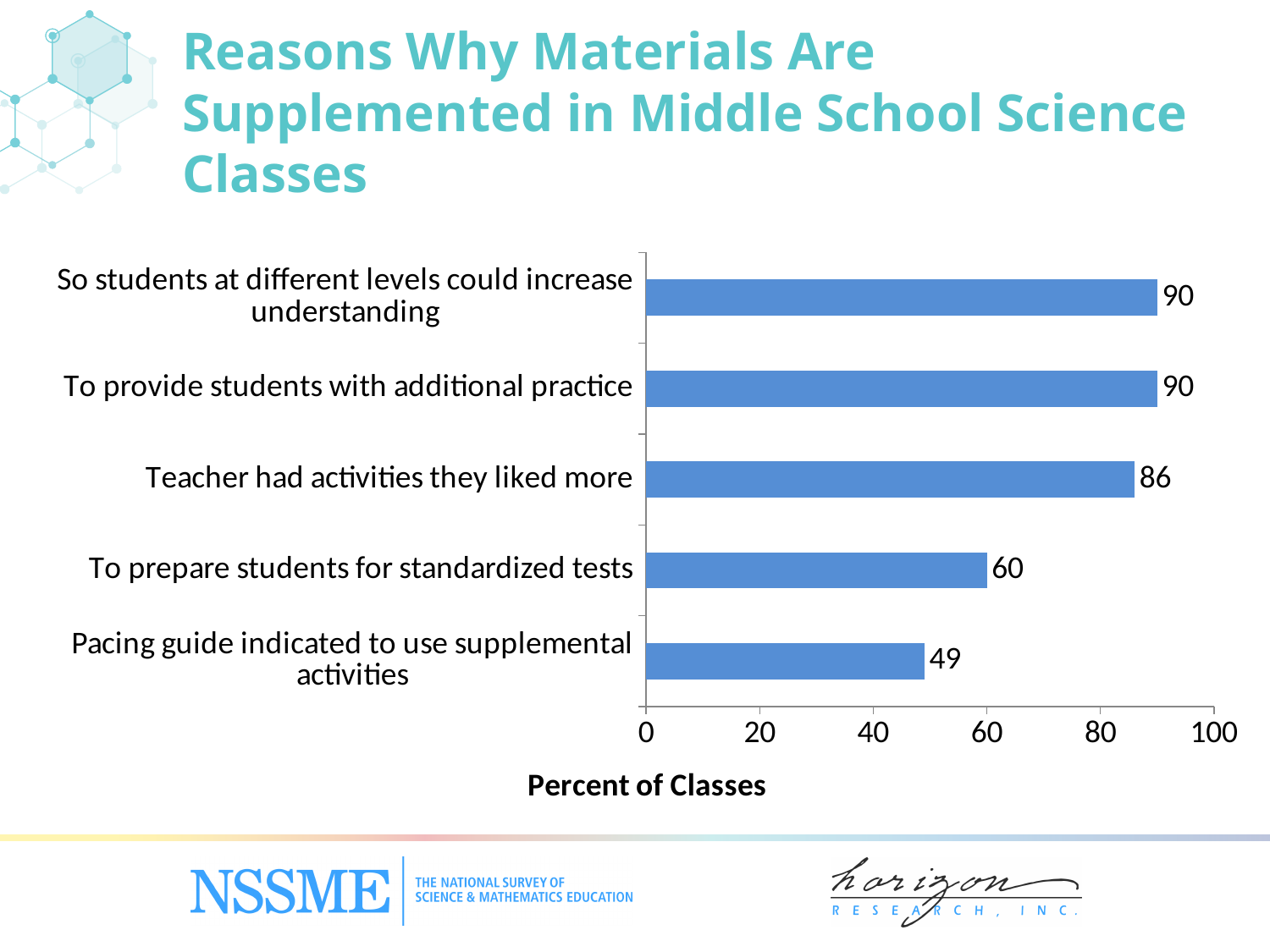
What is the label of the horizontal axis? Percent of Classes What is the difference in percent of classes between 'Teacher had activities they liked more' and 'To prepare students for standardized tests'? 26 What percent of classes supplemented materials to provide students with additional practice? 90 Which reason has the lowest percent of classes? Pacing guide indicated to use supplemental activities Is the value for 'Pacing guide indicated to use supplemental activities' greater or less than 60? less How many reasons are shown in the chart? 5 What kind of chart is shown on the slide? Bar chart What percent of classes supplemented materials because the teacher had activities they liked more? 86 Which has a higher percent of classes: 'To prepare students for standardized tests' or 'Teacher had activities they liked more'? Teacher had activities they liked more What percent of classes supplemented materials because the pacing guide indicated to use supplemental activities? 49 What percent of classes supplemented materials to prepare students for standardized tests? 60 What is the difference in percent of classes between 'To provide students with additional practice' and 'Pacing guide indicated to use supplemental activities'? 41